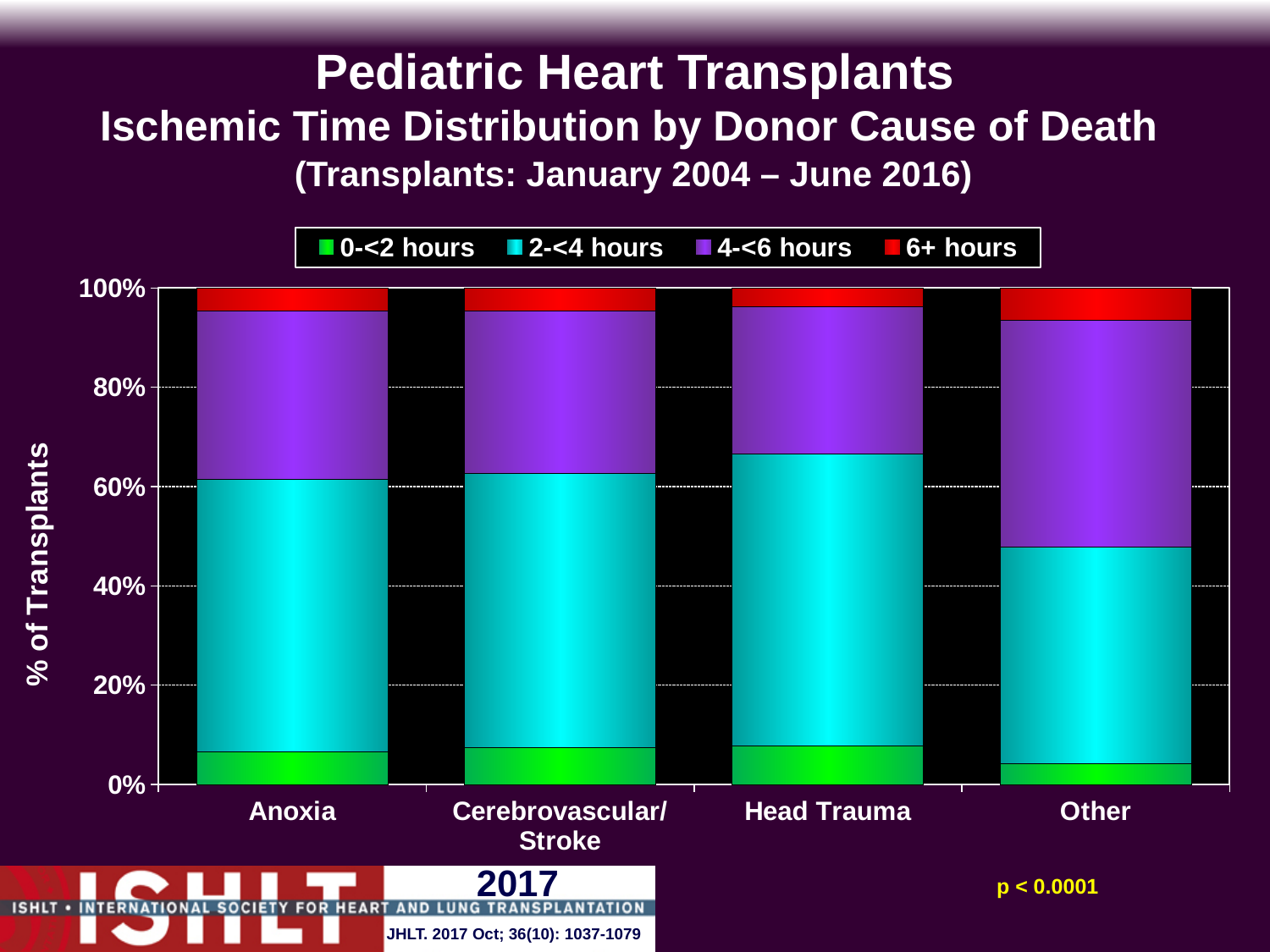
Which category has the largest 6+ hours share? Other Which colour represents the 6+ hours series in the legend? Red Which category has the largest 4-<6 hours share? Other Which category has the smallest 0-<2 hours share? Other What is the label on the y axis? % of Transplants Is the 4-<6 hours share for Other larger or smaller than for Head Trauma? larger Is the 2-<4 hours share for Head Trauma larger or smaller than for Other? larger What kind of chart is shown on the slide? Stacked bar chart How many donor cause of death categories are shown on the x axis? 4 Is the top of the 2-<4 hours segment for Other greater or less than 60%? less Is the top of the 2-<4 hours segment for Head Trauma greater or less than 60%? greater How many series does the legend list? 4